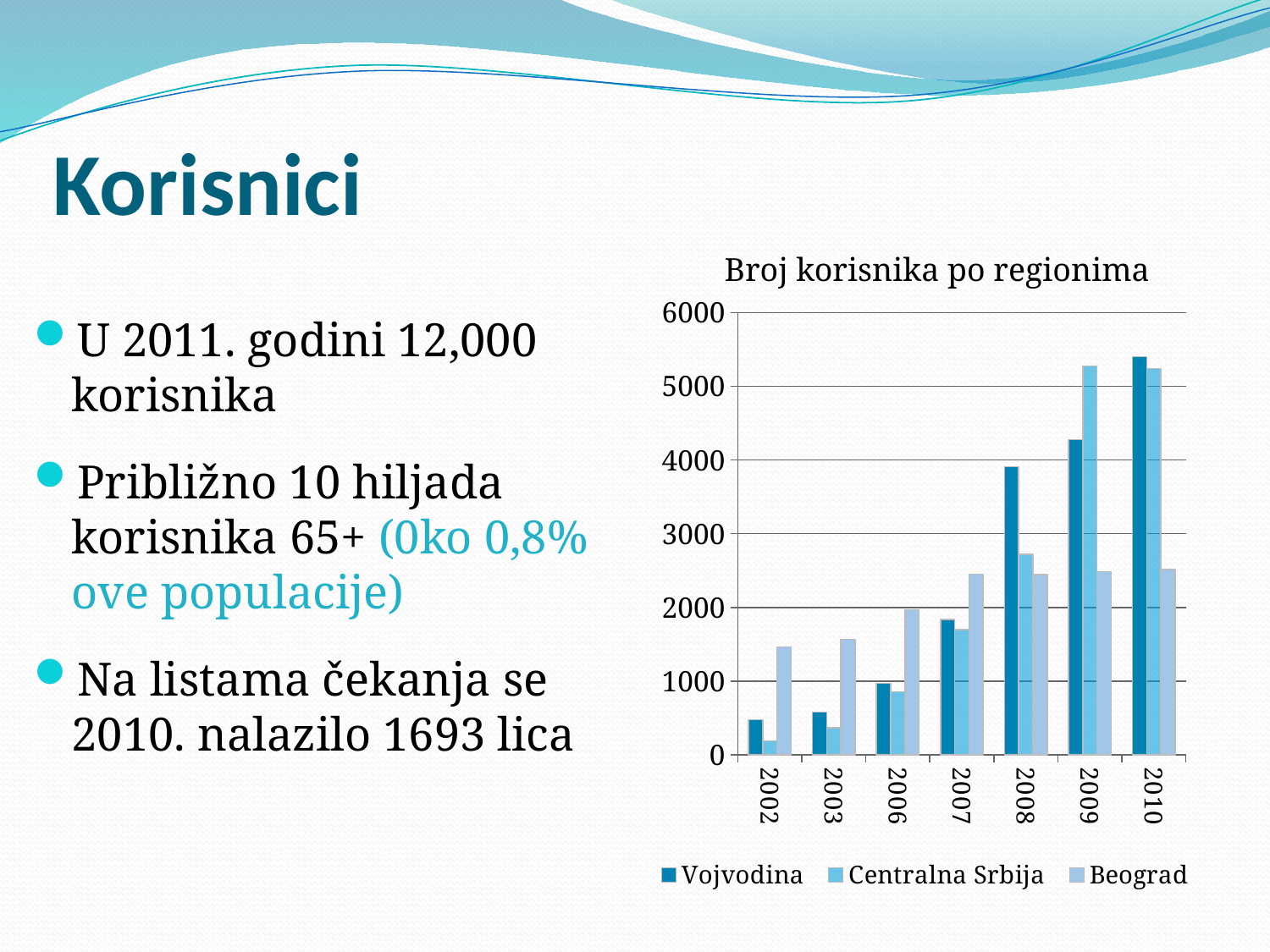
Is the value for Beograd in 2008 greater or less than 2000? greater How many series does the chart legend list? 3 Do the values for Vojvodina rise or fall from 2002 to 2010? rise In 2009, which is larger: Centralna Srbija or Beograd? Centralna Srbija Is the value for Centralna Srbija in 2002 greater or less than 1000? less Is the value for Vojvodina in 2010 greater or less than 5000? greater What kind of chart is shown on the slide? bar chart What is the title of the chart? Broj korisnika po regionima Which series is shown in the darkest blue in the chart? Vojvodina In 2002, which series has the highest value? Beograd How many years are shown on the x axis of the chart? 7